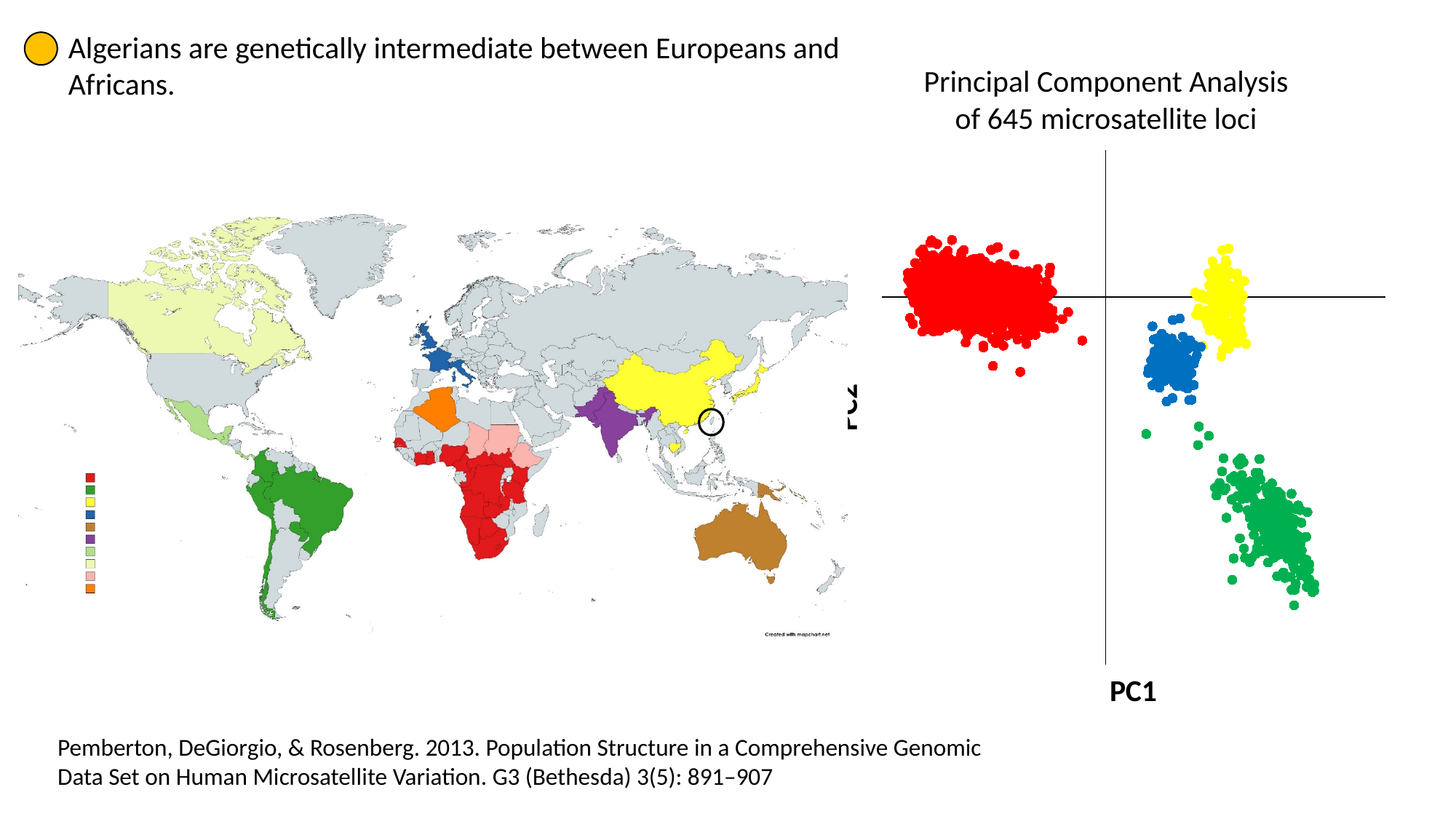
In the Principal Component Analysis chart, which coloured cluster lies furthest to the left along PC1? red What kind of chart is the "Principal Component Analysis of 645 microsatellite loci" chart? scatter chart In the Principal Component Analysis chart, which coloured cluster lies lowest on the PC2 axis? green In the Principal Component Analysis chart, which cluster is further left along PC1, the red cluster or the yellow cluster? red In the Principal Component Analysis chart, which coloured cluster lies furthest to the right along PC1? green In the Principal Component Analysis chart, how many distinct coloured clusters of points are plotted? 4 In the Principal Component Analysis chart, is the red cluster to the left or to the right of the vertical axis line? left What is the title of the chart on the right side of the slide? Principal Component Analysis of 645 microsatellite loci In the Principal Component Analysis chart, which cluster is further right along PC1, the blue cluster or the green cluster? green In the Principal Component Analysis chart, what is the label of the horizontal axis? PC1